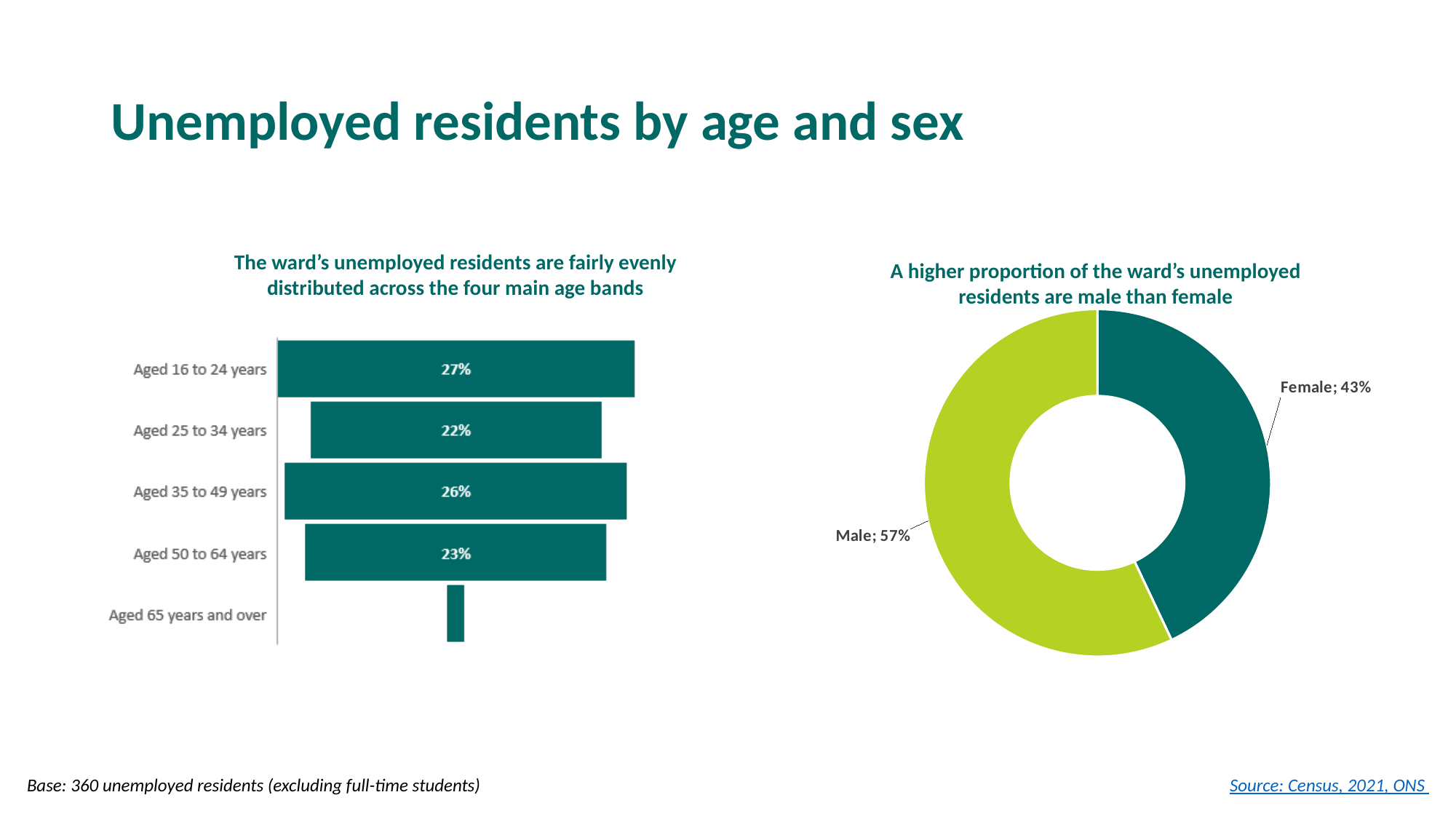
How many age bands are shown in the bar chart on the left? 5 In the bar chart on the left, which age band has the lowest share of unemployed residents? Aged 65 years and over In the bar chart on the left, what percentage of unemployed residents are aged 50 to 64 years? 23% In the doughnut chart on the right, what percentage of unemployed residents are male? 57% What kind of chart is the chart on the left? Bar chart In the doughnut chart on the right, what is the difference between the male and female shares? 14% In the bar chart on the left, which is larger: the share aged 25 to 34 years or the share aged 50 to 64 years? Aged 50 to 64 years In the bar chart on the left, what percentage of unemployed residents are aged 35 to 49 years? 26% In the bar chart on the left, what percentage of unemployed residents are aged 16 to 24 years? 27% In the bar chart on the left, which age band has the highest share of unemployed residents? Aged 16 to 24 years What kind of chart is the chart on the right? Doughnut chart In the bar chart on the left, what is the difference between the shares for those aged 16 to 24 years and those aged 25 to 34 years? 5%